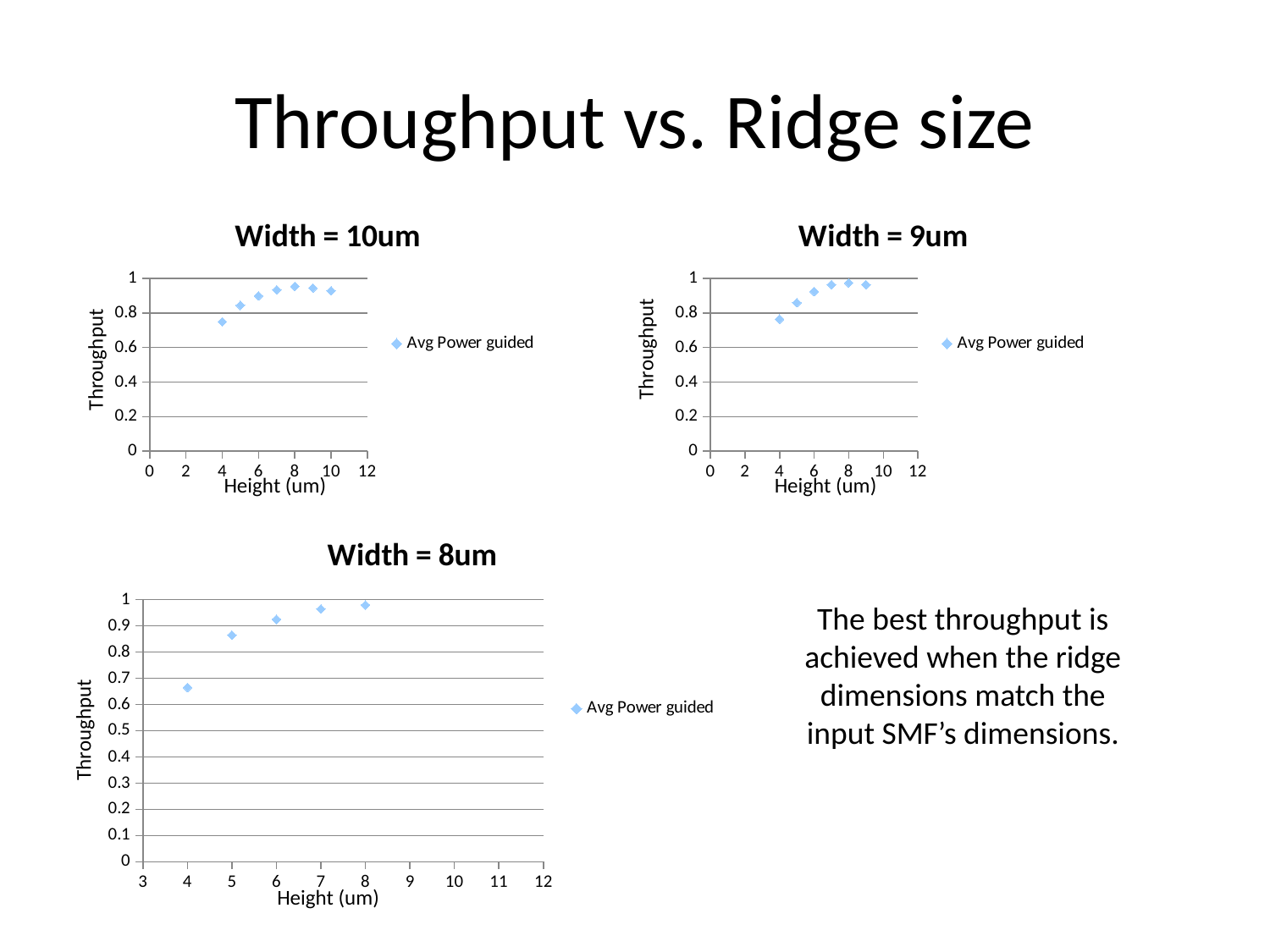
In the "Width = 8um" chart, is the throughput at height 4 um greater or less than 0.7? less In the "Width = 9um" chart, is the throughput at height 8 um greater or less than 0.8? greater How many data points are plotted in the "Width = 10um" chart? 7 In the "Width = 8um" chart, is the throughput at height 8 um greater or less than 0.9? greater What is the legend entry in the "Width = 9um" chart? Avg Power guided How many data points are plotted in the "Width = 8um" chart? 5 How many series does the legend of the "Width = 10um" chart list? 1 How many data points are plotted in the "Width = 9um" chart? 6 What kind of chart is the "Width = 8um" chart? scatter chart In the "Width = 8um" chart, at which height is the throughput lowest? 4 In the "Width = 8um" chart, does throughput rise or fall as height increases? rise